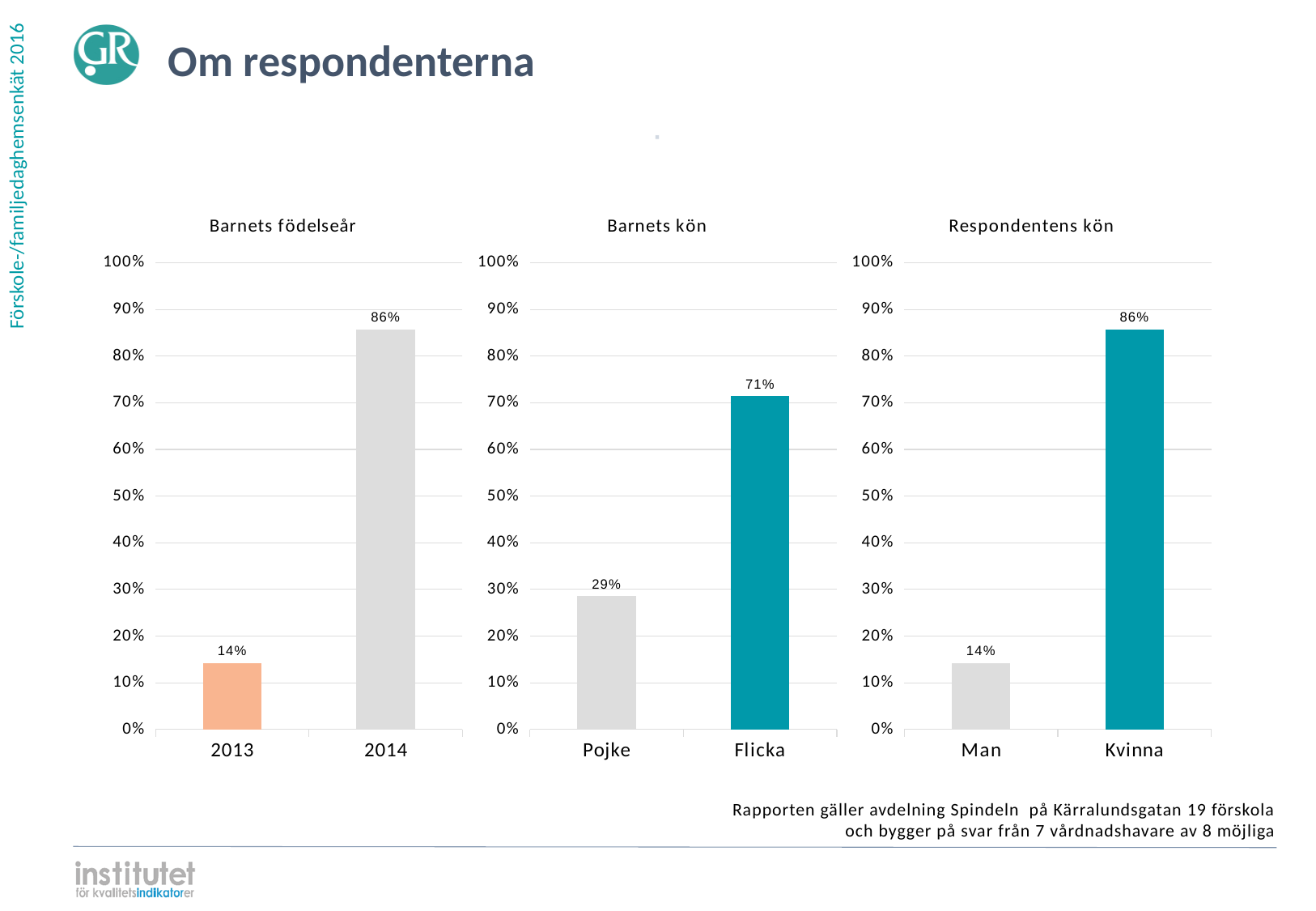
In the 'Barnets kön' chart, what is the value for Flicka? 71% In the 'Barnets kön' chart, what is the value for Pojke? 29% In the 'Barnets kön' chart, which category has the lowest value? Pojke In the 'Respondentens kön' chart, which category has the highest value? Kvinna In the 'Respondentens kön' chart, what is the value for Man? 14% In the 'Barnets födelseår' chart, what is the difference between 2014 and 2013? 72% In the 'Barnets födelseår' chart, what is the value for 2014? 86% In the 'Respondentens kön' chart, which is larger, Man or Kvinna? Kvinna In the 'Barnets födelseår' chart, what is the value for 2013? 14% How many categories are shown in the 'Barnets kön' chart? 2 What type of chart is the 'Respondentens kön' chart? Bar chart In the 'Barnets kön' chart, what is the difference between Flicka and Pojke? 42%